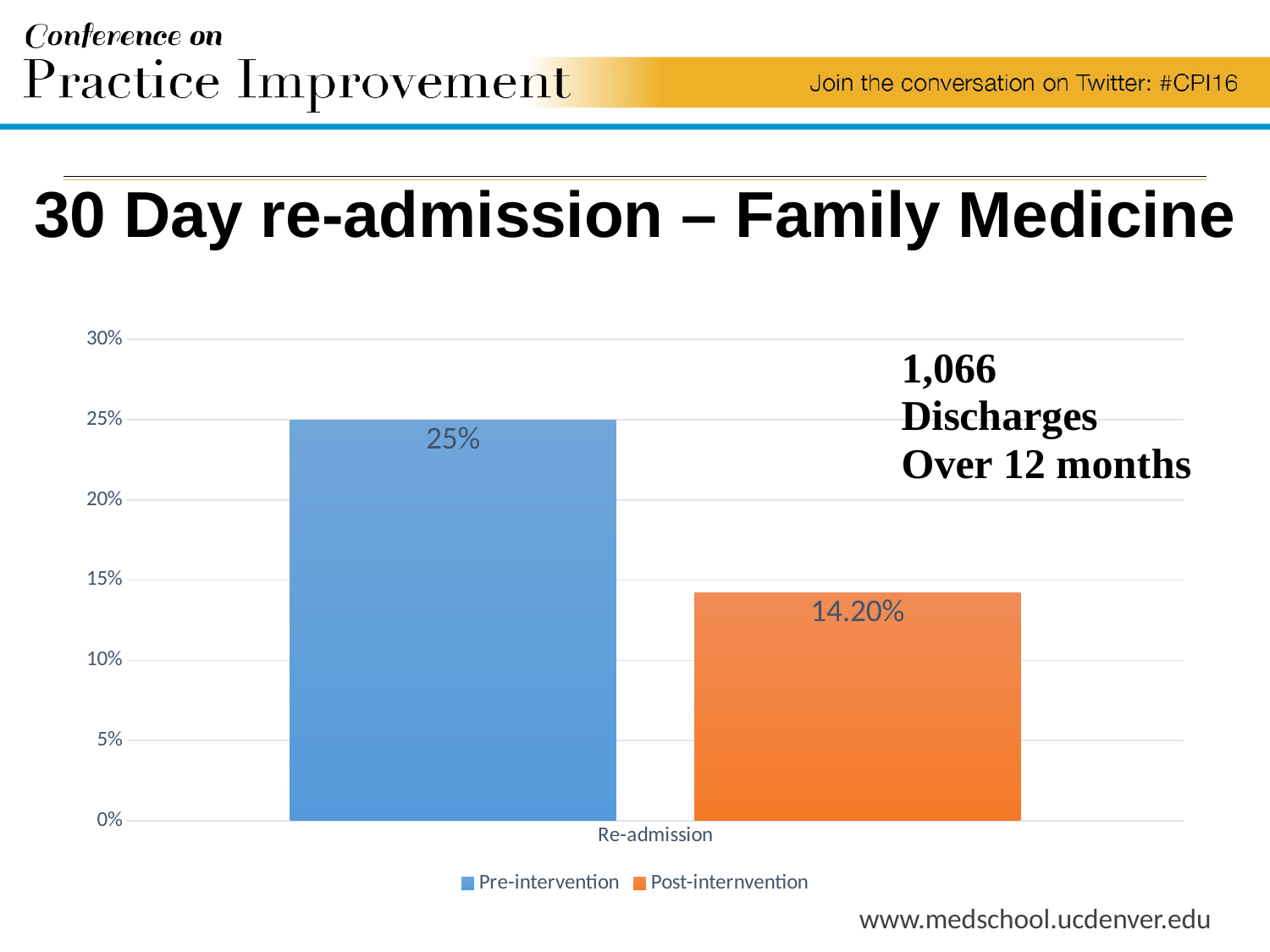
Is the Post-internvention value greater or less than 15%? less What kind of chart is shown on the slide? bar chart What is the Pre-intervention re-admission value? 25% What colour is the Post-internvention bar? orange Which series has the higher re-admission value, Pre-intervention or Post-internvention? Pre-intervention How many series does the legend list? 2 Is the Pre-intervention value greater or less than 20%? greater How many categories are shown on the x axis? 1 Which series has the lowest re-admission value? Post-internvention What is the difference between the Pre-intervention and Post-internvention re-admission values? 10.80% What is the Post-internvention re-admission value? 14.20% What is the category label on the x axis? Re-admission